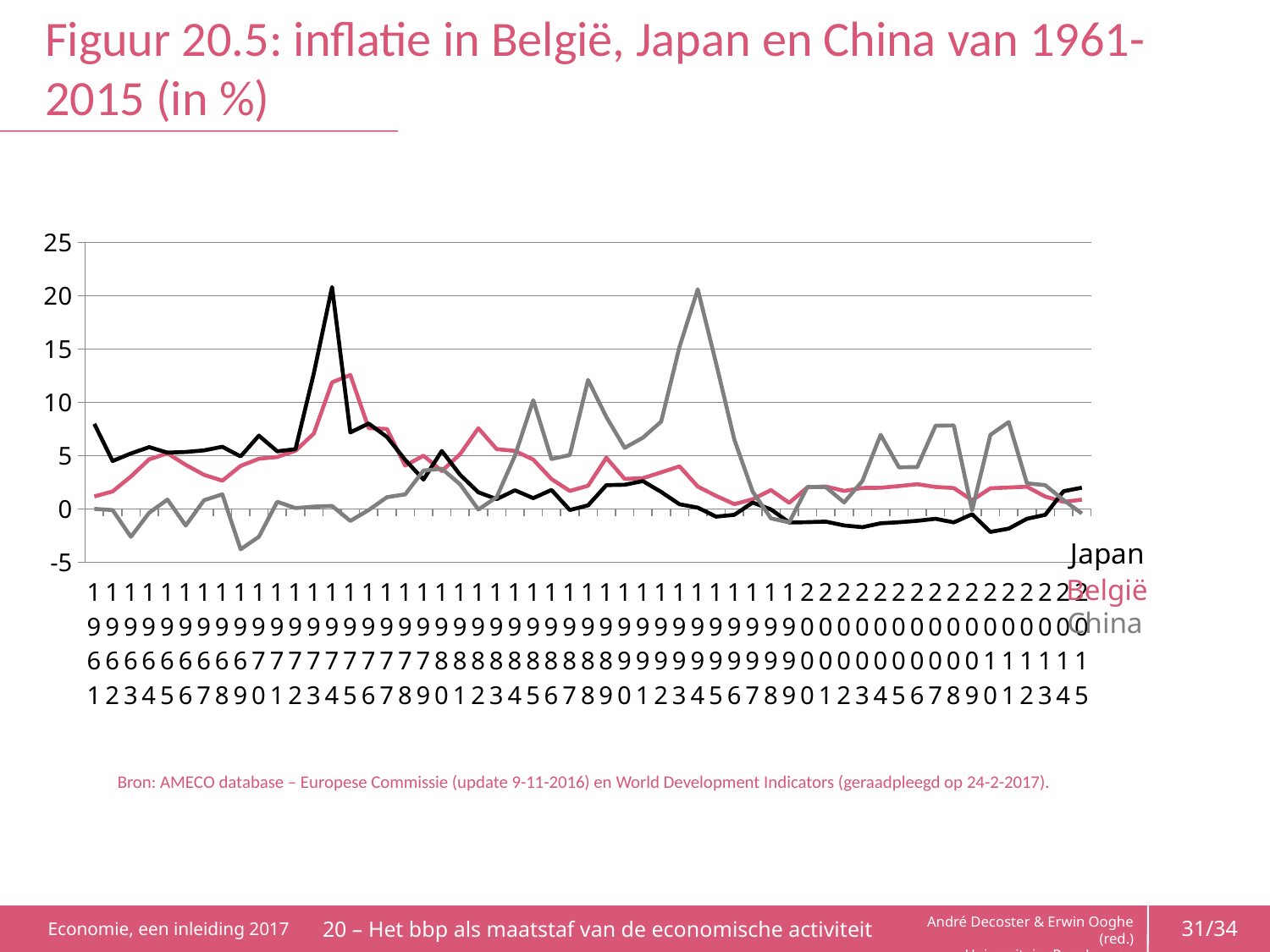
Is the inflation value for China in 1994 greater or less than 15? greater In 1974, which country has the higher inflation value, Japan or België? Japan What is the title of the chart? Figuur 20.5: inflatie in België, Japan en China van 1961-2015 (in %) What kind of chart is shown on the slide? line chart How many years does the x axis cover, from 1961 to 2015? 55 How many series does the legend list? 3 Is the inflation value for Japan in 1974 greater or less than 15? greater Is the inflation value for België in 1974 greater or less than 10? greater Does the inflation line for Japan rise or fall between 1974 and 1987? fall Which three countries are listed in the legend? Japan, België, China